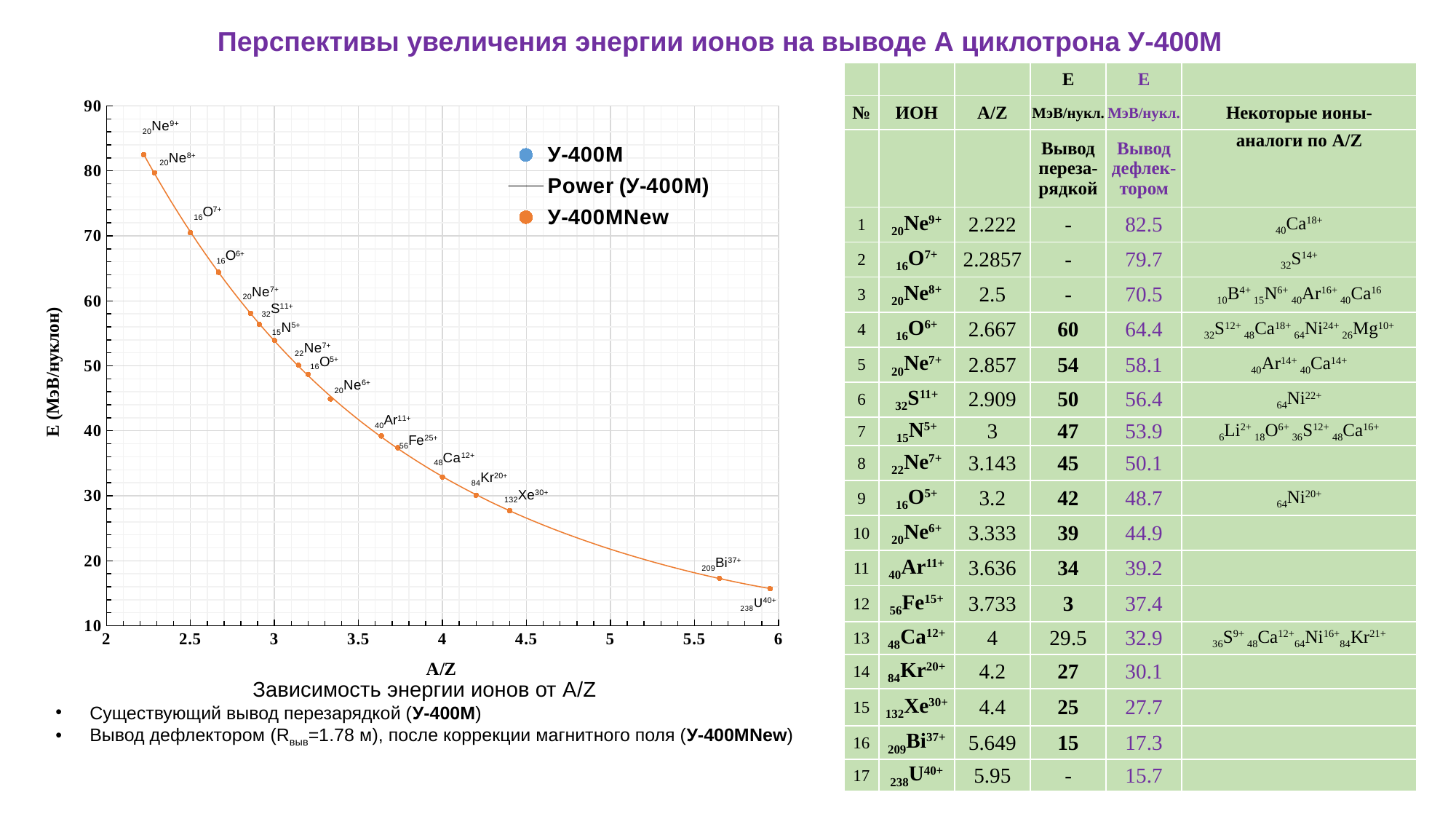
What kind of chart is shown on the slide? scatter chart Is the energy value for 48Ca12+ greater or less than 30? greater Which ion has the lowest energy value on the chart? 238U40+ Is the energy value for 132Xe30+ greater or less than 30? less What is the title of the chart's x axis? A/Z Do the energy values rise or fall as A/Z increases along the x axis? fall How many entries does the chart legend list? 3 Is the energy value for 16O6+ greater or less than 60? greater How many labelled ion points are plotted on the chart? 17 Which ion has the highest energy value on the chart? 20Ne9+